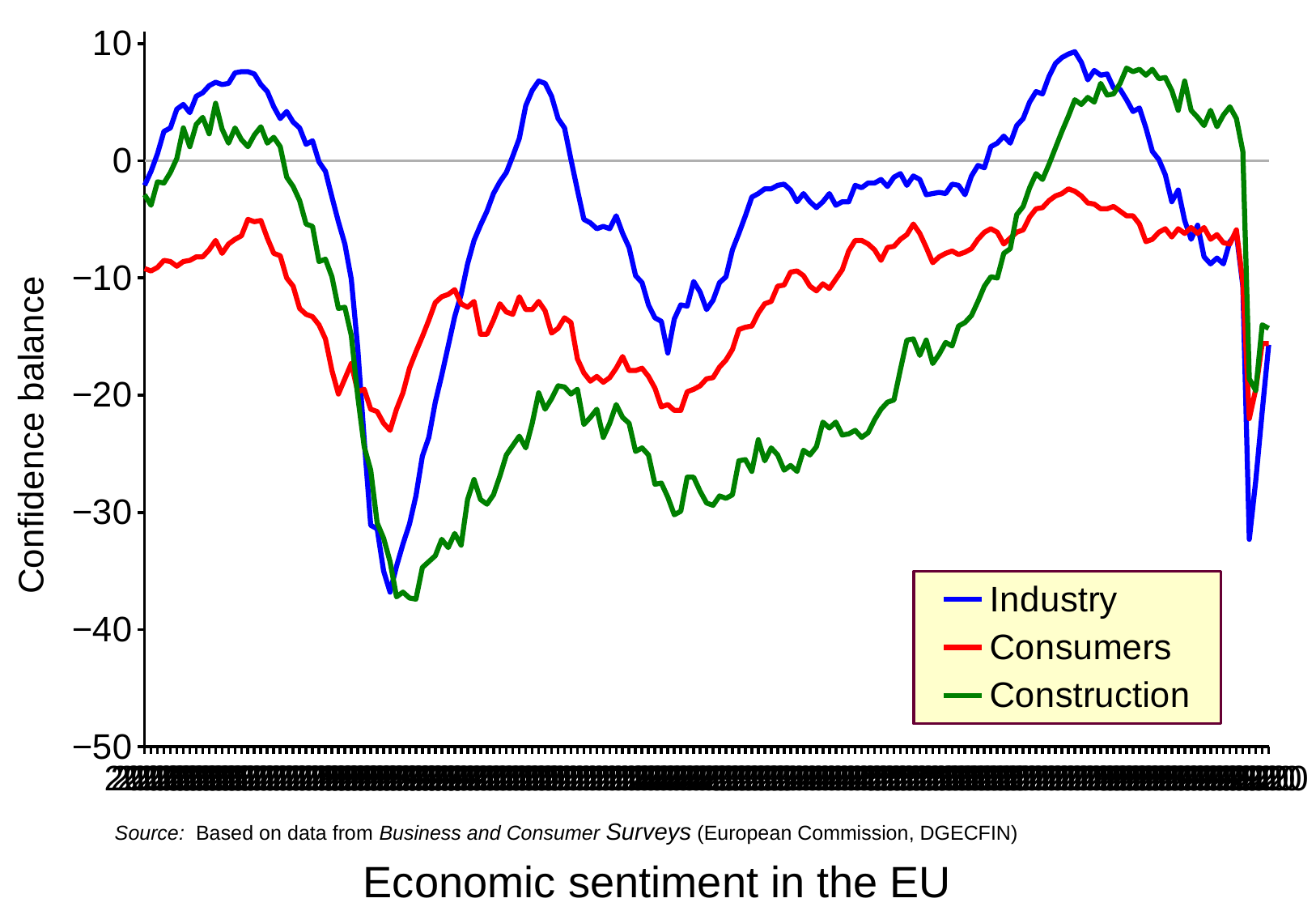
Is the lowest value reached by the Consumers series greater or less than -20? less Which series reaches a lower minimum, Consumers or Construction? Construction What is the label on the vertical axis? Confidence balance Is the lowest value reached by the Construction series greater or less than -30? less How many series does the legend list? 3 What kind of chart is shown on the slide? Line chart Is the lowest value reached by the Industry series greater or less than -30? less Which series never rises above 0 anywhere on the chart? Consumers Which series reaches a higher maximum, Consumers or Industry? Industry What is the title of the chart? Economic sentiment in the EU